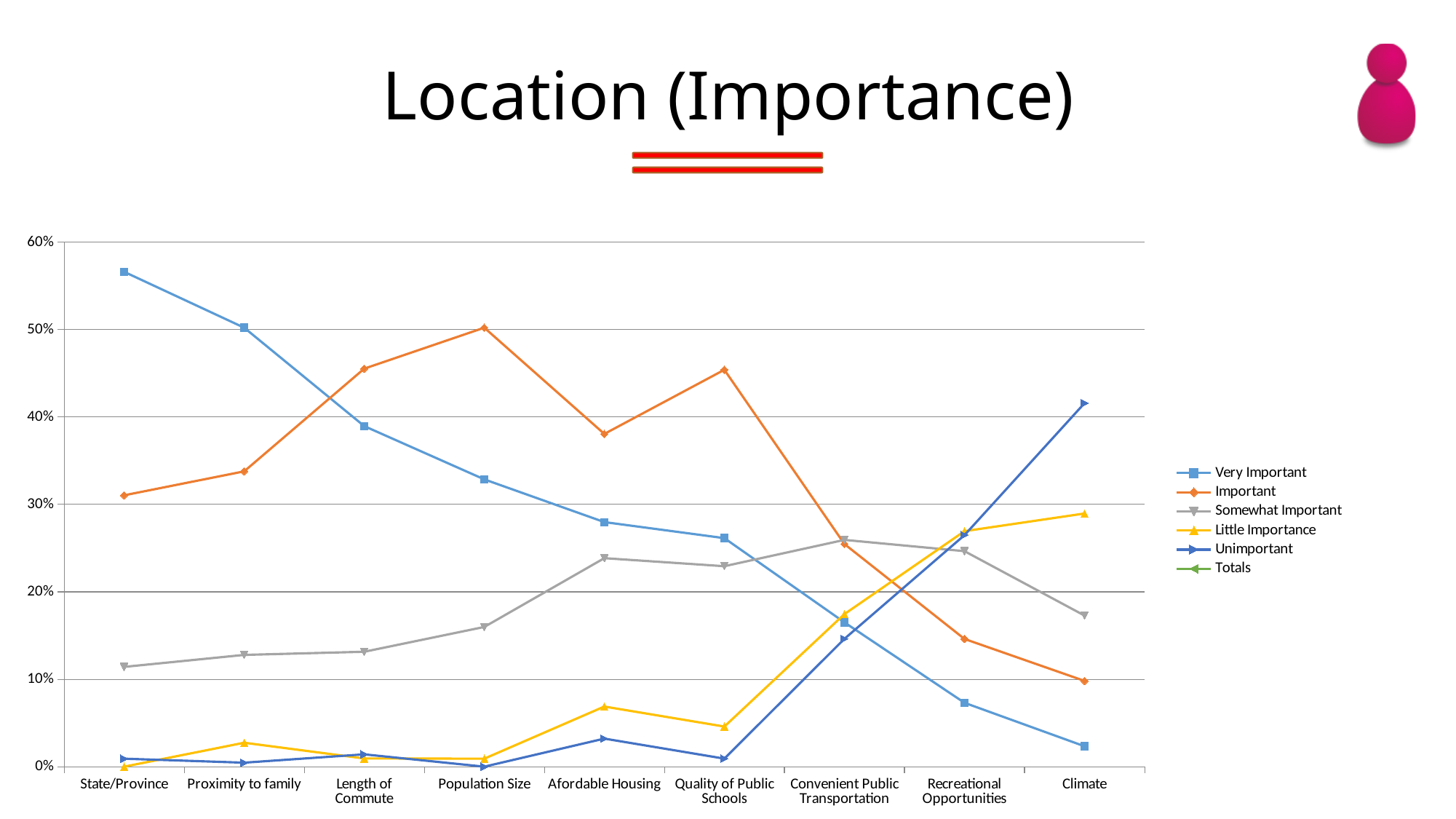
What type of chart is shown on the slide? Line chart How many location factors are shown along the x axis? 9 Is the Important value for Climate greater or less than 20%? less For which location factor is the Unimportant series highest? Climate Is the Very Important value for State/Province greater or less than 50%? greater Does the Very Important series rise or fall moving from State/Province to Climate along the x axis? Falls At Climate, which is larger: Unimportant or Little Importance? Unimportant At Length of Commute, which is larger: Important or Very Important? Important For which location factor is the Important series highest? Population Size For which location factor is the Very Important series highest? State/Province For which location factor is the Very Important series lowest? Climate How many series does the legend list? 6